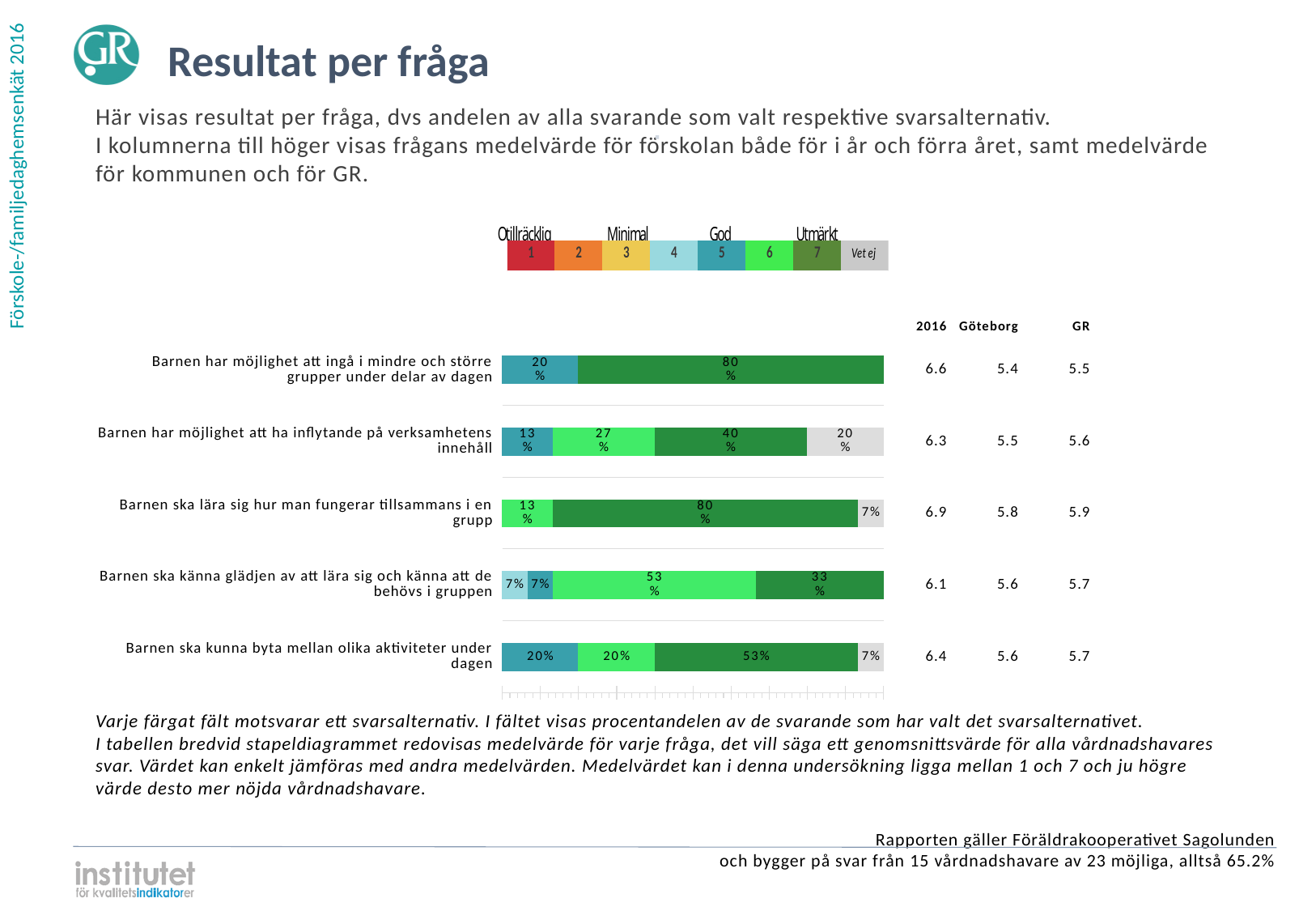
What percentage of respondents chose answer 6 for 'Barnen ska känna glädjen av att lära sig och känna att de behövs i gruppen'? 53% What percentage of respondents answered 'Vet ej' for 'Barnen har möjlighet att ha inflytande på verksamhetens innehåll'? 20% Which has a larger share of answer 7: 'Barnen har möjlighet att ingå i mindre och större grupper under delar av dagen' or 'Barnen ska kunna byta mellan olika aktiviteter under dagen'? Barnen har möjlighet att ingå i mindre och större grupper under delar av dagen How many response categories does the legend above the chart list, including 'Vet ej'? 8 What percentage of respondents chose answer 7 (Utmärkt) for 'Barnen har möjlighet att ingå i mindre och större grupper under delar av dagen'? 80% What is the 2016 mean value for 'Barnen ska lära sig hur man fungerar tillsammans i en grupp'? 6.9 For 'Barnen har möjlighet att ingå i mindre och större grupper under delar av dagen', how many percentage points larger is the share for answer 7 than the share for answer 5? 60 percentage points Which question has the lowest 2016 mean value? Barnen ska känna glädjen av att lära sig och känna att de behövs i gruppen Which question has the highest 2016 mean value? Barnen ska lära sig hur man fungerar tillsammans i en grupp What kind of chart is used to show the results per question on this slide? Stacked bar chart How many questions (bars) are shown in the chart? 5 What is the Göteborg mean value for 'Barnen ska kunna byta mellan olika aktiviteter under dagen'? 5.6